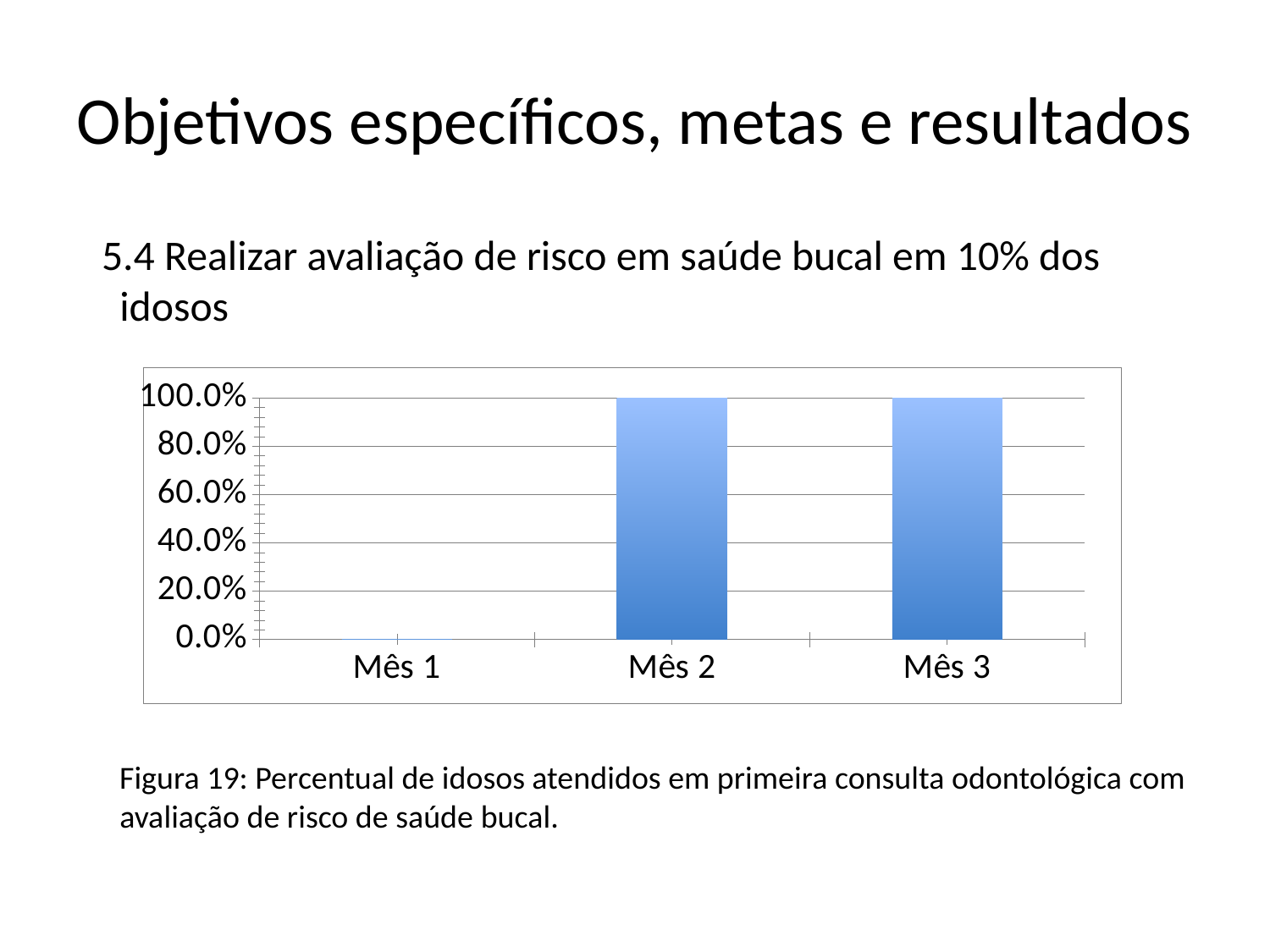
Is the value for Mês 2 greater or less than 80.0%? greater What is the value for Mês 1? 0.0% How many categories are shown on the x axis? 3 Is the value for Mês 1 greater or less than 20.0%? less What is the difference between the value for Mês 3 and the value for Mês 1? 100.0% What is the value for Mês 3? 100.0% Do the values rise or fall from Mês 1 to Mês 2? rise Which is larger, the value for Mês 1 or the value for Mês 2? Mês 2 What kind of chart is shown on the slide? bar chart Which month has the lowest value? Mês 1 What is the value for Mês 2? 100.0% What figure number is given in the caption below the chart? Figura 19